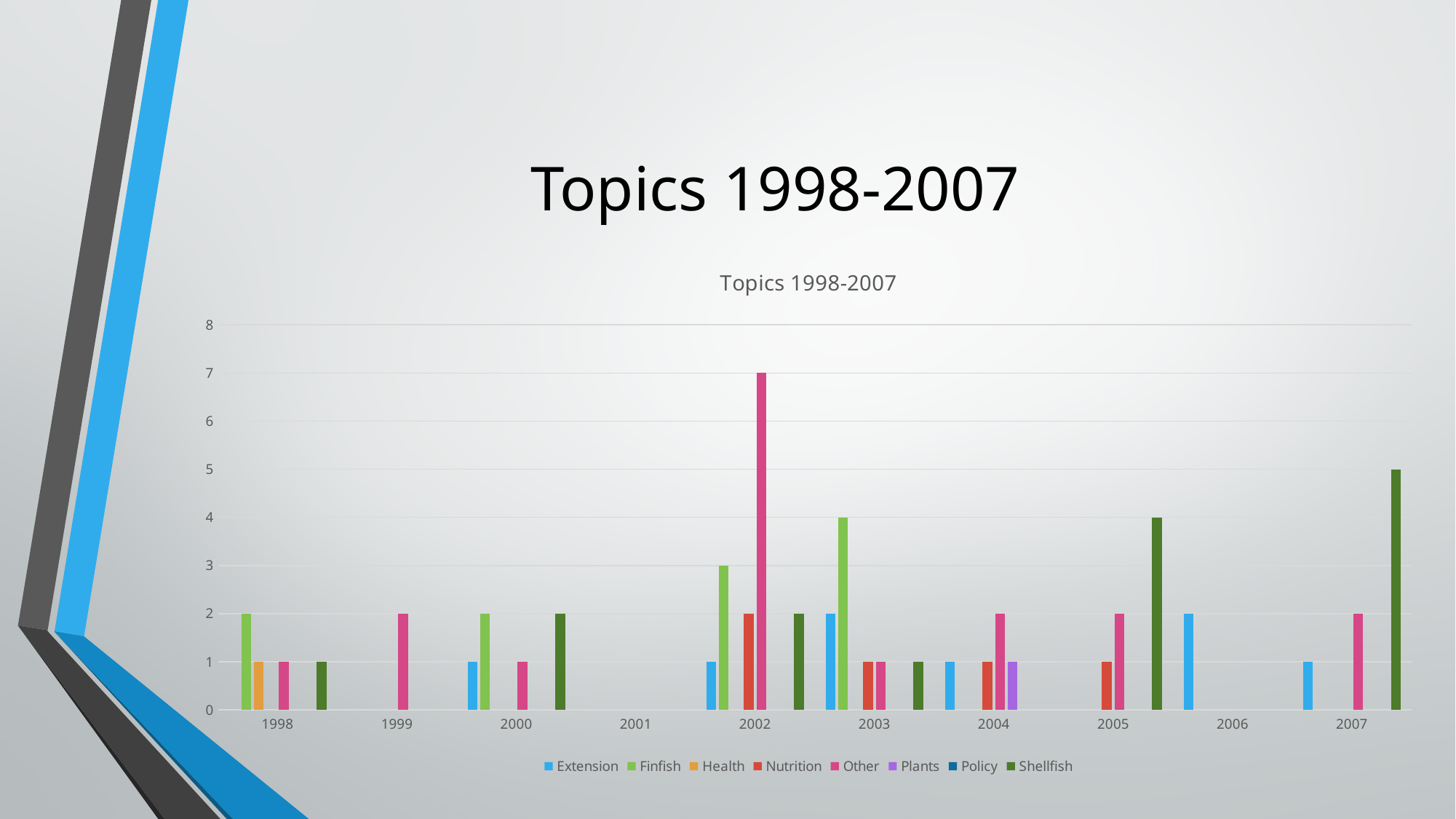
What is the value for Other in 2002? 7 What is the title of the chart? Topics 1998-2007 Which is larger, Shellfish in 2005 or Shellfish in 2007? Shellfish in 2007 What type of chart is shown on the slide? bar chart How many years are shown on the x axis? 10 What is the value for Finfish in 2003? 4 Is the value for Other in 2002 greater or less than 6? greater Which year has no bars at all? 2001 What is the value for Shellfish in 2007? 5 What is the difference between the Other value in 2002 and the Finfish value in 2002? 4 How many series does the legend list? 8 Which year has the tallest bar in the chart? 2002